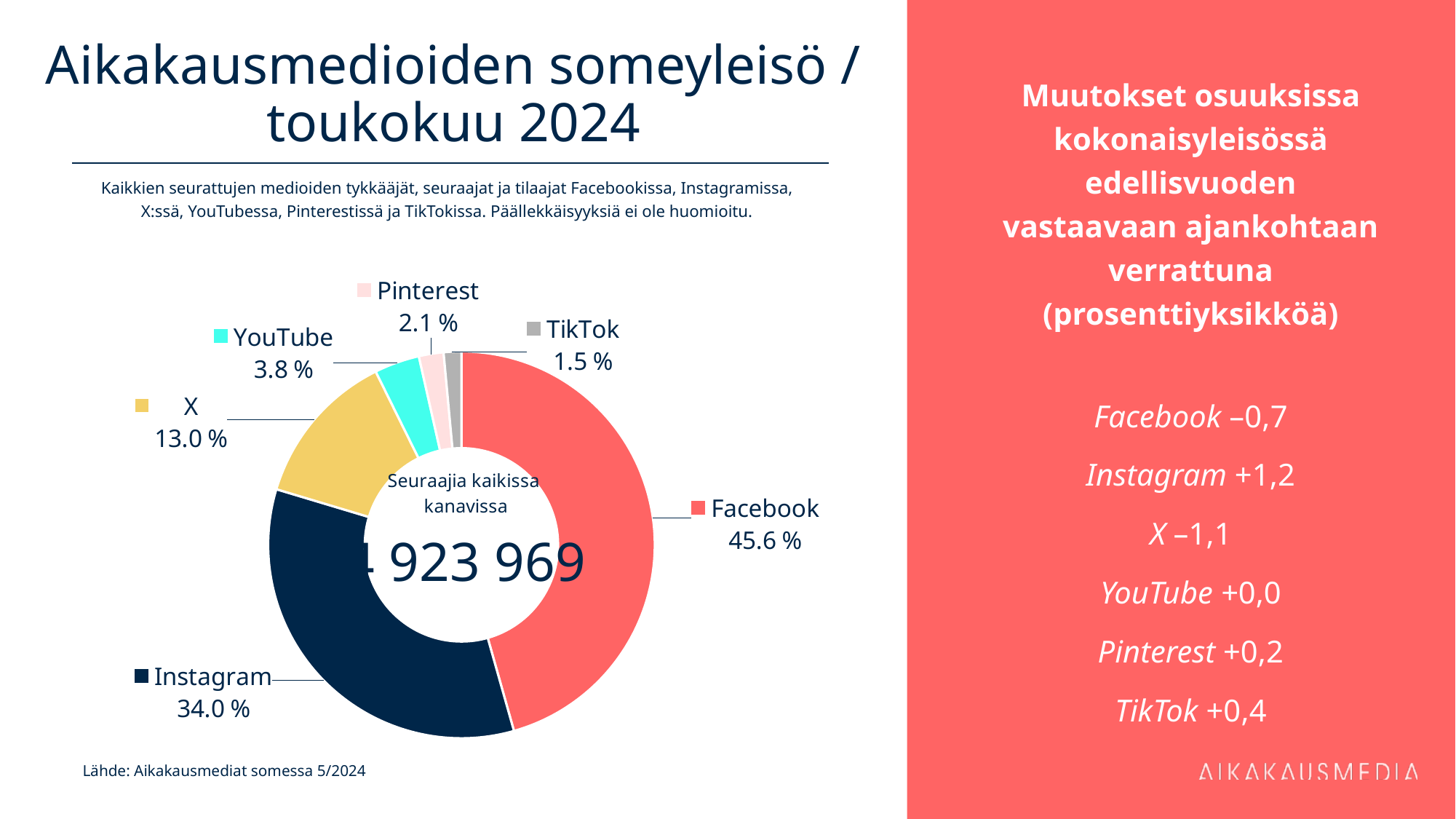
What share of the social media audience does X have? 13.0 % What colour is the Instagram slice in the chart? Dark navy blue What kind of chart is shown on the slide? Pie (donut) chart What share of the social media audience does TikTok have? 1.5 % What share of the social media audience does Instagram have? 34.0 % How many channels are shown in the chart? 6 Which channel has the smallest share of the audience? TikTok What is the difference in percentage points between Facebook's and Instagram's shares? 11.6 What share of the social media audience does Facebook have? 45.6 % Which has a larger share, Pinterest or YouTube? YouTube Which channel has the largest share of the audience? Facebook What share of the social media audience does YouTube have? 3.8 %